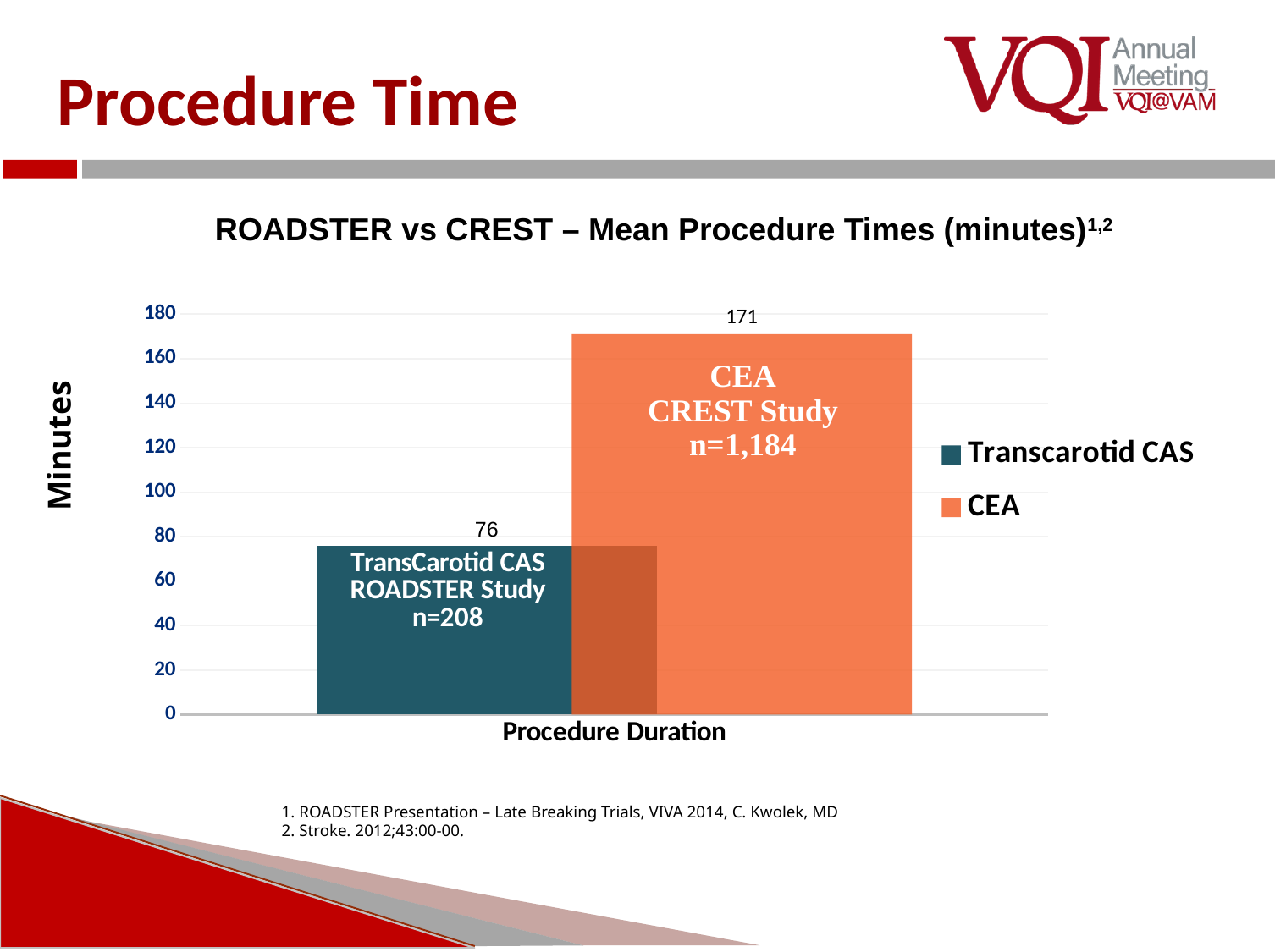
What is the category label on the x axis of the chart? Procedure Duration What is the mean procedure time for CEA? 171 Is the value for Transcarotid CAS greater or less than 80? less How many bars are plotted in the chart? 2 What is the difference in minutes between the CEA and Transcarotid CAS mean procedure times? 95 What is the label on the y axis of the chart? Minutes What kind of chart is shown on the slide? bar chart Which series has the lowest mean procedure time? Transcarotid CAS Is the value for CEA greater or less than 160? greater Which series has the higher mean procedure time, Transcarotid CAS or CEA? CEA How many series does the legend list? 2 What is the mean procedure time for Transcarotid CAS? 76